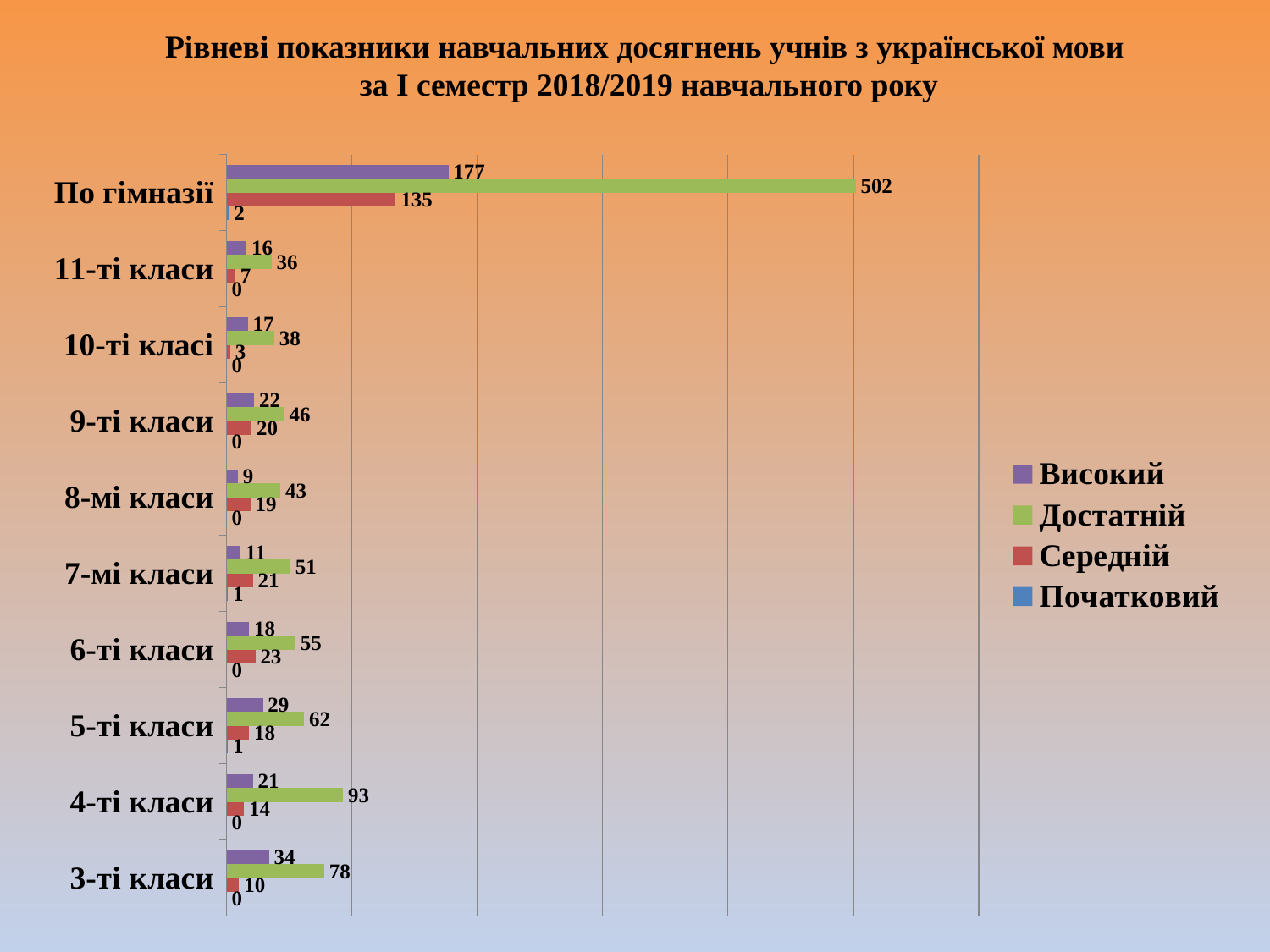
What is the difference between the Достатній and Високий values for По гімназії? 325 Among the class categories (excluding По гімназії), which has the lowest Високий value? 8-мі класи How many series does the legend list? 4 What is the value of Високий for 5-ті класи? 29 Among the class categories (excluding По гімназії), which has the highest Достатній value? 4-ті класи What is the value of Початковий for 7-мі класи? 1 What kind of chart is shown on the slide? bar chart What is the value of Достатній for По гімназії? 502 Which is larger: the Високий value for 3-ті класи or the Високий value for 4-ті класи? 3-ті класи What is the value of Середній for 6-ті класи? 23 How many categories are shown on the vertical axis? 10 Which series is shown in green in the legend? Достатній